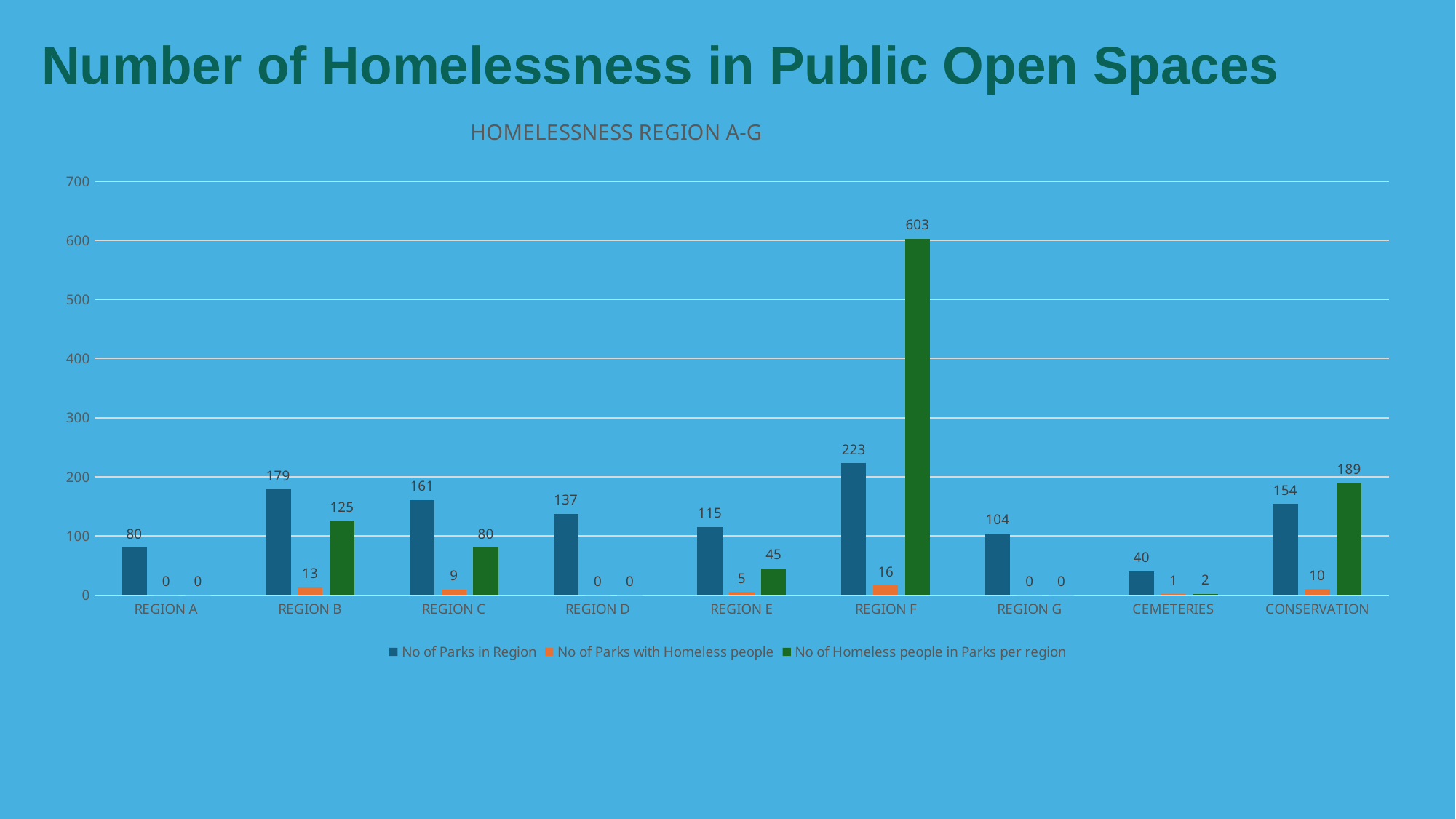
Which category has the lowest number of parks in region? Cemeteries How many categories are shown on the x axis? 9 What is the difference between the number of parks in Region C and the number of parks in Region D? 24 What kind of chart is shown on the slide? Bar chart Which category has the highest number of parks in region? Region F What is the title of the chart? HOMELESSNESS REGION A-G Which is larger: the number of homeless people in parks in Region B or in Conservation? Conservation What is the number of homeless people in parks for Region F? 603 How many series does the legend list? 3 Which series is shown in orange? No of Parks with Homeless people How many parks with homeless people are there in Conservation? 10 How many parks are in Region B? 179